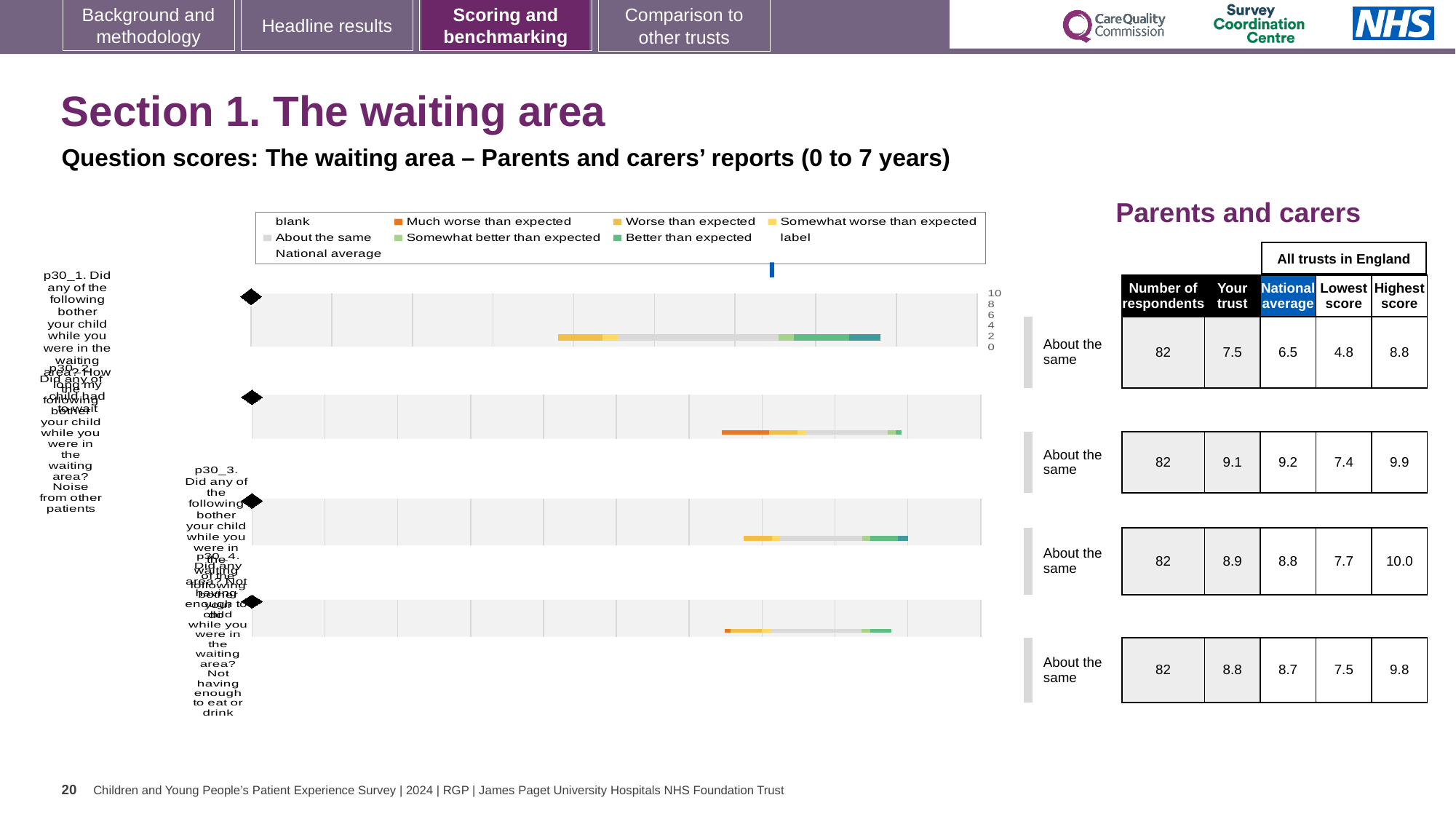
What benchmark category is shown beside each of the four question rows? About the same What is the 'Your trust' score for the first question (p30_1, how long my child had to wait)? 7.5 What is the national average for the second question (p30_2, noise from other patients)? 9.2 What is the highest score across all trusts in England for the third question (p30_3, not having enough to do)? 10.0 What kind of chart is shown on the slide? bar chart What is the difference between the 'Your trust' score and the national average for the first question (p30_1)? 1.0 How many respondents answered each of the four questions? 82 How many question rows (categories) does the chart show? 4 How many entries does the chart legend list? 9 For the second question (p30_2), which is larger: the 'Your trust' score or the national average? National average What is the lowest score across all trusts in England for the fourth question (p30_4, not having enough to eat or drink)? 7.5 Which question has the lowest 'Your trust' score? p30_1 (how long my child had to wait)